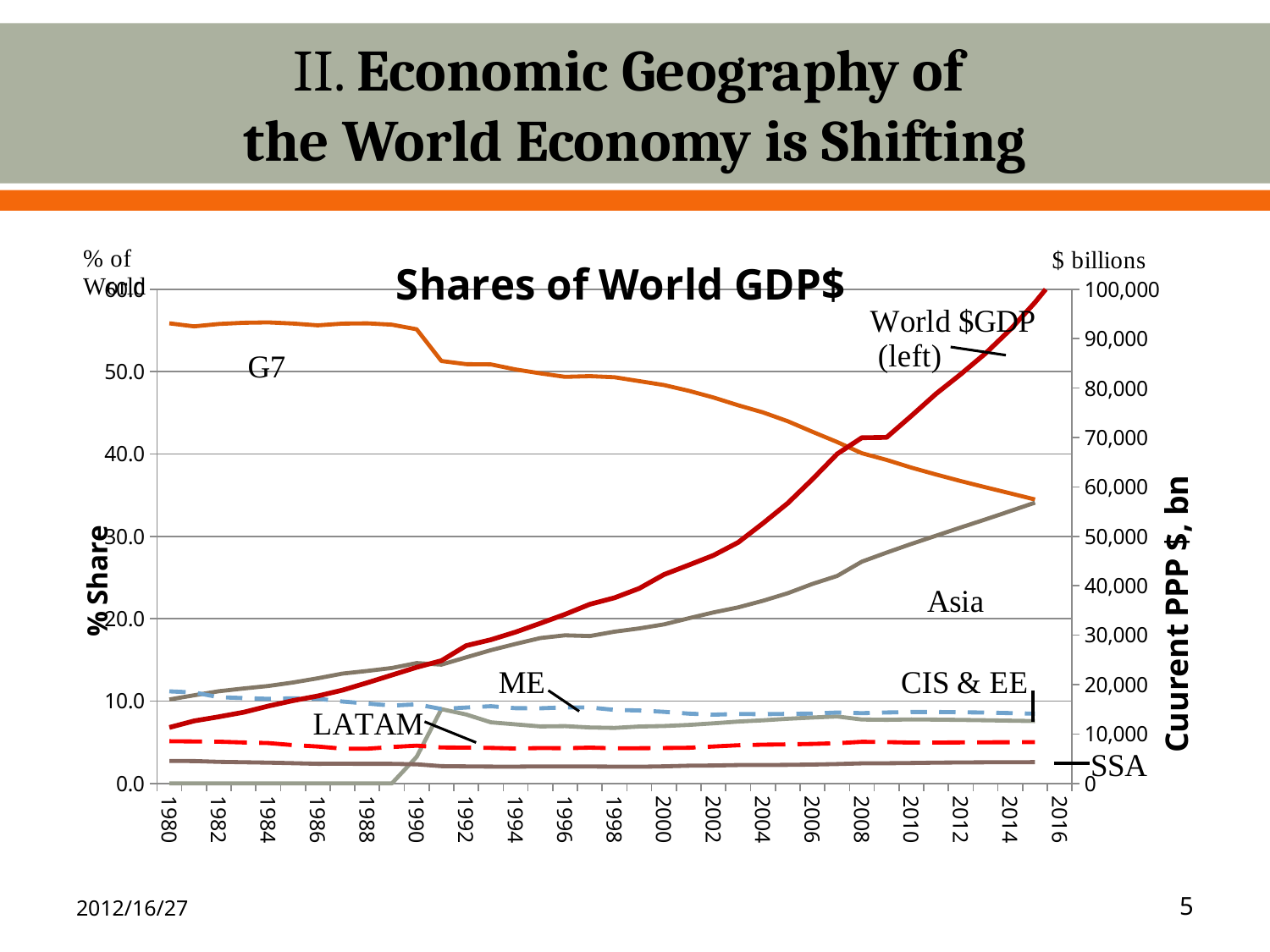
Is the G7 share in 1980 greater or less than 50.0? greater Does the Asia share of world GDP rise or fall from 1980 to 2016? rise How many series are labeled on the chart? 7 What is the label of the right-hand vertical axis? Cuurent PPP $, bn Does the World $GDP line rise or fall from 1980 to 2016? rise What kind of chart is shown on the slide? line chart Is the Asia share in 2014 greater or less than 30.0? greater What is the title of the chart? Shares of World GDP$ Which series has the highest share of world GDP in 1980? G7 Is the Asia share in 1980 greater or less than 20.0? less Does the G7 share of world GDP rise or fall from 1980 to 2016? fall